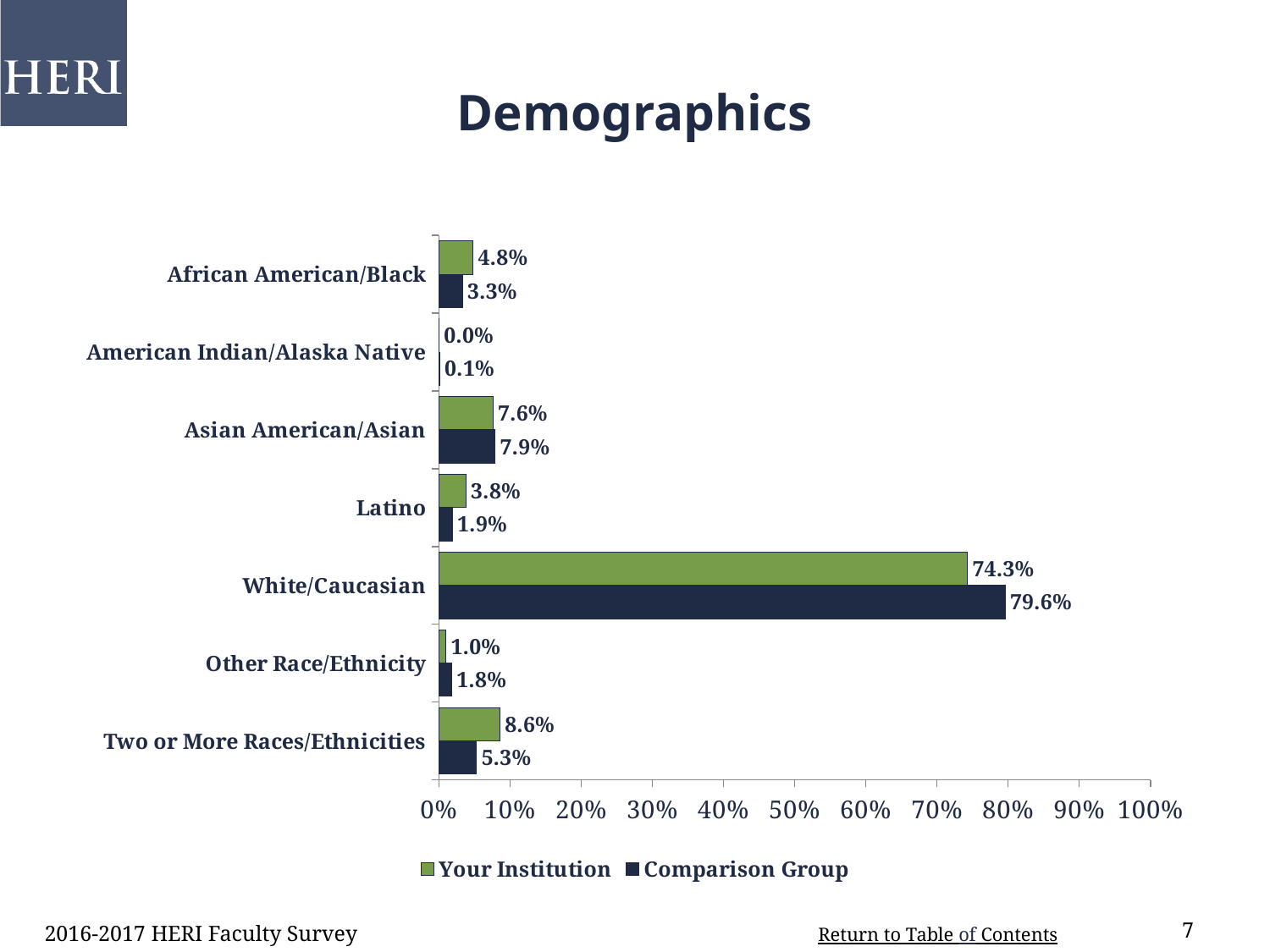
Which category has the highest value for Comparison Group? White/Caucasian What kind of chart is shown on the slide? bar chart How many categories are shown on the chart? 7 What is the value for Your Institution for White/Caucasian? 74.3% Which category has the lowest value for Your Institution? American Indian/Alaska Native What is the difference between the Comparison Group and Your Institution values for White/Caucasian? 5.3% Which is larger for Latino: Your Institution or Comparison Group? Your Institution What is the value for Comparison Group for Asian American/Asian? 7.9% Is the Comparison Group value for White/Caucasian greater or less than 70%? greater Which series is shown in green in the legend? Your Institution How many series does the legend list? 2 What is the value for Your Institution for Two or More Races/Ethnicities? 8.6%